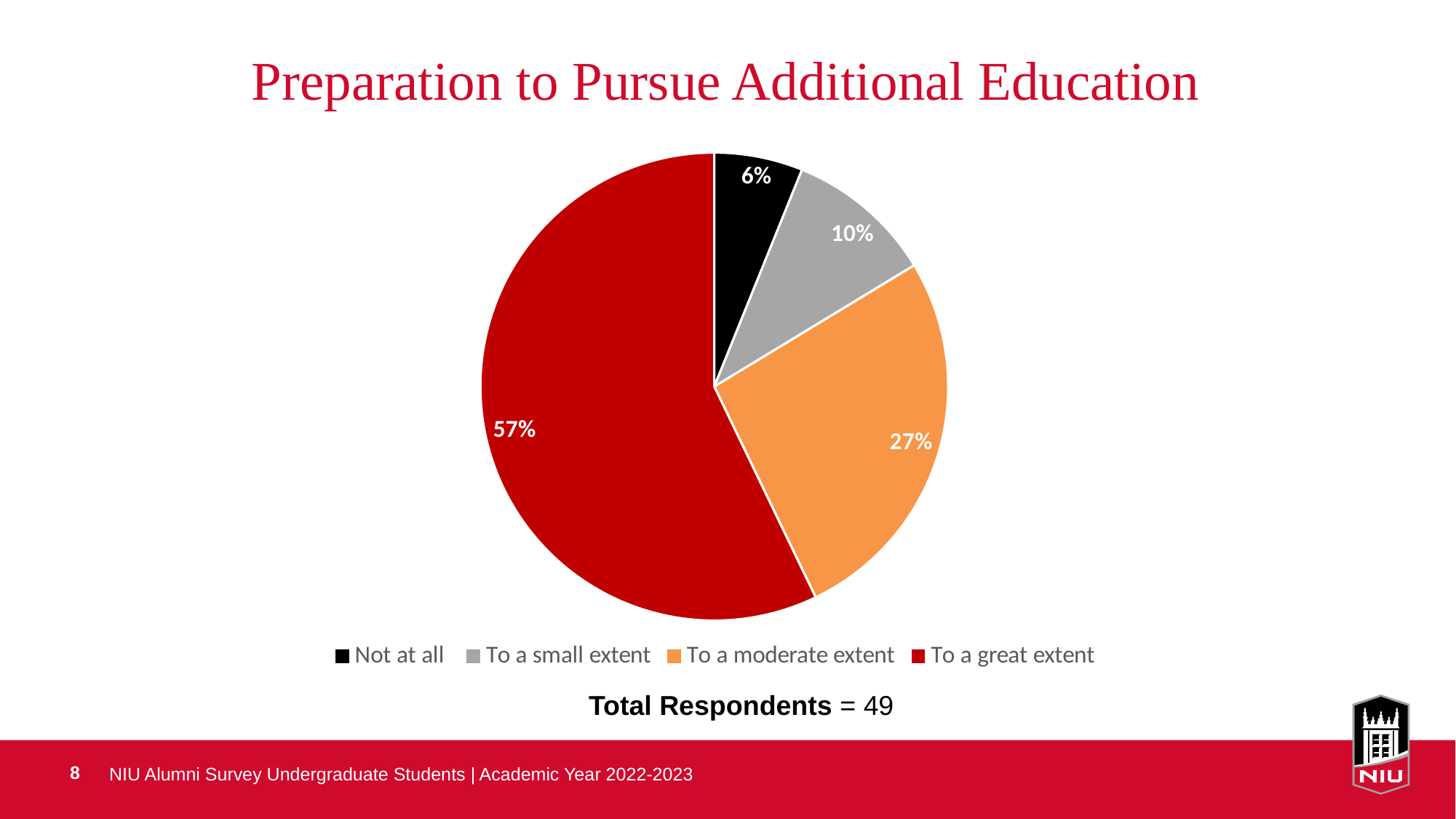
What percentage of respondents answered "To a great extent"? 57% What percentage of respondents answered "Not at all"? 6% What colour is the slice for "To a moderate extent"? orange Which response category has the smallest share of the pie? Not at all What kind of chart is shown on the slide? pie chart How many categories does the legend list? 4 What percentage of respondents answered "To a small extent"? 10% Which is larger, the share for "To a small extent" or the share for "Not at all"? To a small extent What is the title of the chart? Preparation to Pursue Additional Education What percentage of respondents answered "To a moderate extent"? 27% What is the difference in percentage points between "To a great extent" and "To a moderate extent"? 30 Which response category has the largest share of the pie? To a great extent